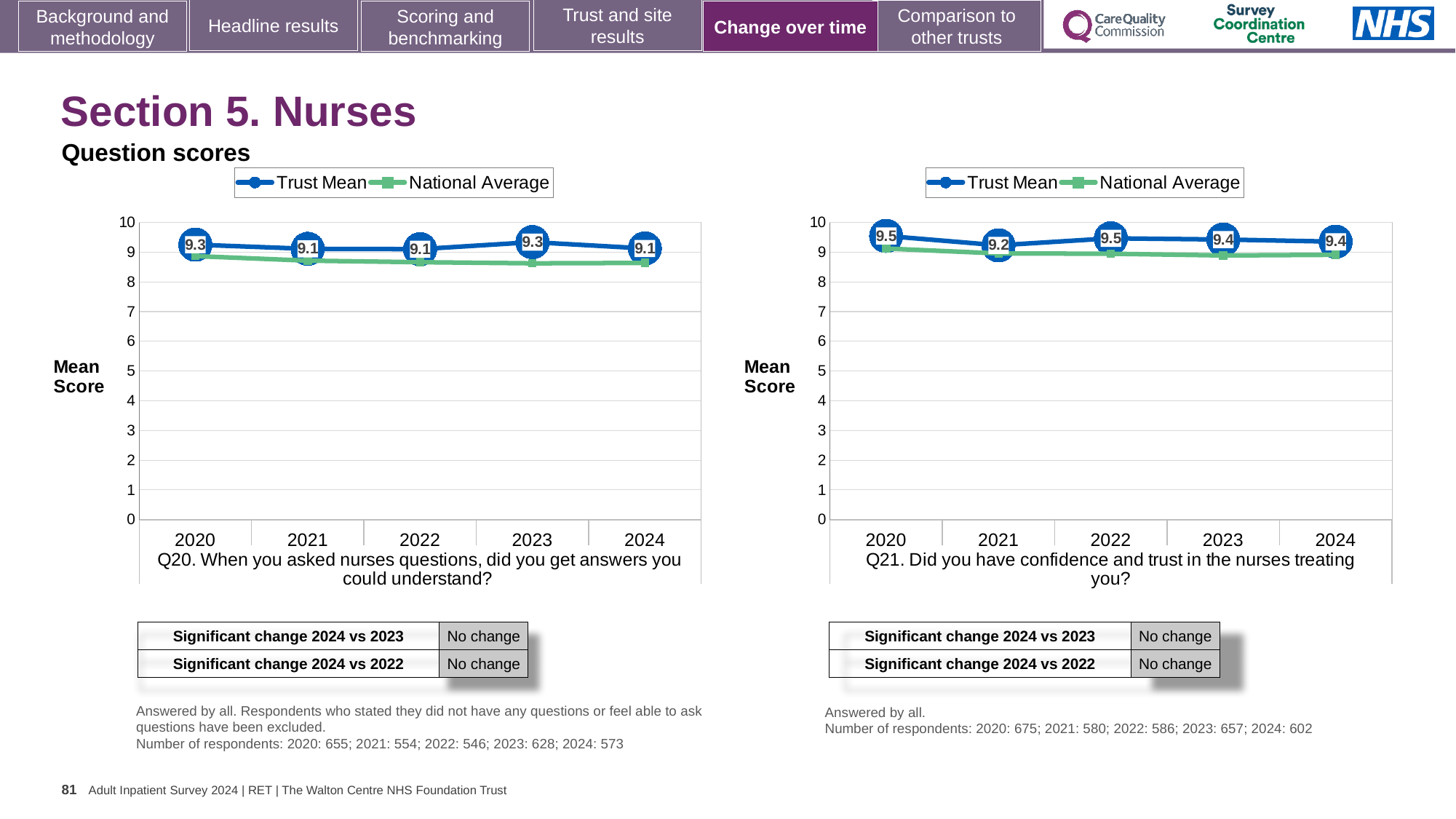
On the Q21 chart (right), which year has the lowest Trust Mean score? 2021 On the Q21 chart (right), what is the Trust Mean score for 2024? 9.4 On the Q20 chart (left), what is the Trust Mean score for 2020? 9.3 How many years are shown on the x axis of the Q20 chart (left)? 5 On the Q20 chart (left), is the National Average value for 2024 greater or less than 8? greater On the Q20 chart (left), what is the difference between the Trust Mean scores for 2020 and 2021? 0.2 What kind of chart is the Q20 chart (left)? Line chart How many series does the legend of the Q21 chart (right) list? 2 On the Q21 chart (right), what is the Trust Mean score for 2022? 9.5 On the Q21 chart (right), which is larger, the Trust Mean for 2020 or for 2021? 2020 On the Q20 chart (left), what is the Trust Mean score for 2024? 9.1 On the Q21 chart (right), what is the difference between the Trust Mean scores for 2020 and 2021? 0.3